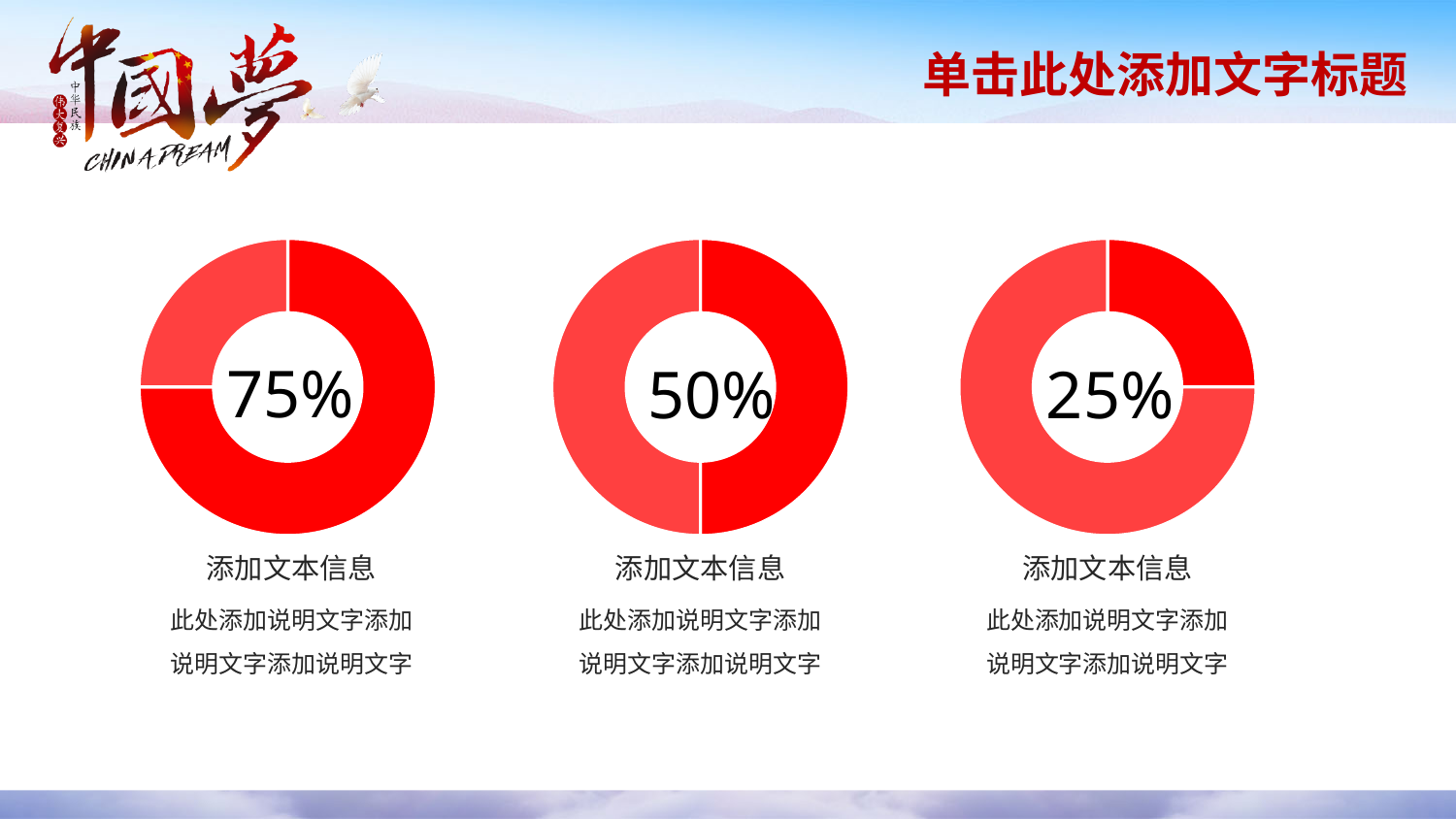
Which donut chart shows the highest percentage, the left, middle or right one? Left What is the difference between the percentage in the left donut chart and the percentage in the right donut chart? 50% What percentage is shown in the centre of the middle donut chart? 50% What percentage is shown in the centre of the left donut chart? 75% What share of the right donut chart is filled by the darker red segment? 25% What percentage is shown in the centre of the right donut chart? 25% How many donut charts are on the slide? 3 Which donut chart shows the lowest percentage, the left, middle or right one? Right Do the percentages in the donut charts rise or fall from left to right across the slide? Fall What kind of chart is used for the three figures on the slide? Donut chart Which is larger, the percentage in the left donut chart or the percentage in the right donut chart? Left What is the difference between the percentage in the left donut chart and the percentage in the middle donut chart? 25%